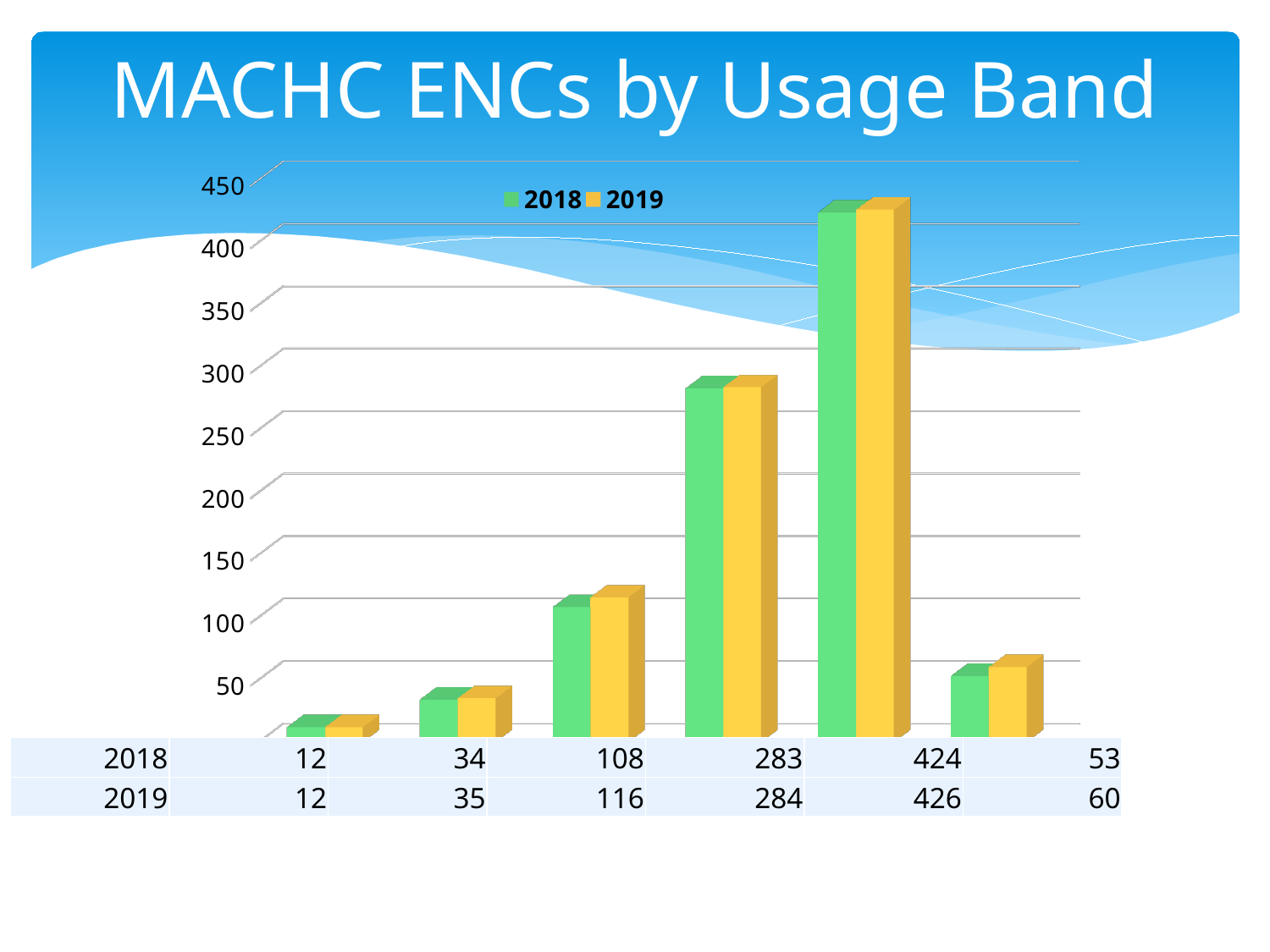
How many series does the legend list? 2 Which is larger for the fifth category from the left, the 2018 value or the 2019 value? 2019 Is the 2019 value for the fifth category from the left greater or less than 400? greater What is the highest value in the 2018 series? 424 What type of chart is shown on the slide? bar chart How many categories are plotted along the x axis? 6 What is the title of the chart? MACHC ENCs by Usage Band What is the difference between the 2019 and 2018 values for the third category from the left? 8 What is the difference between the 2019 and 2018 values for the sixth category from the left? 7 What is the lowest value in the 2019 series? 12 What is the 2019 value for the third category from the left? 116 What is the 2018 value for the fourth category from the left? 283